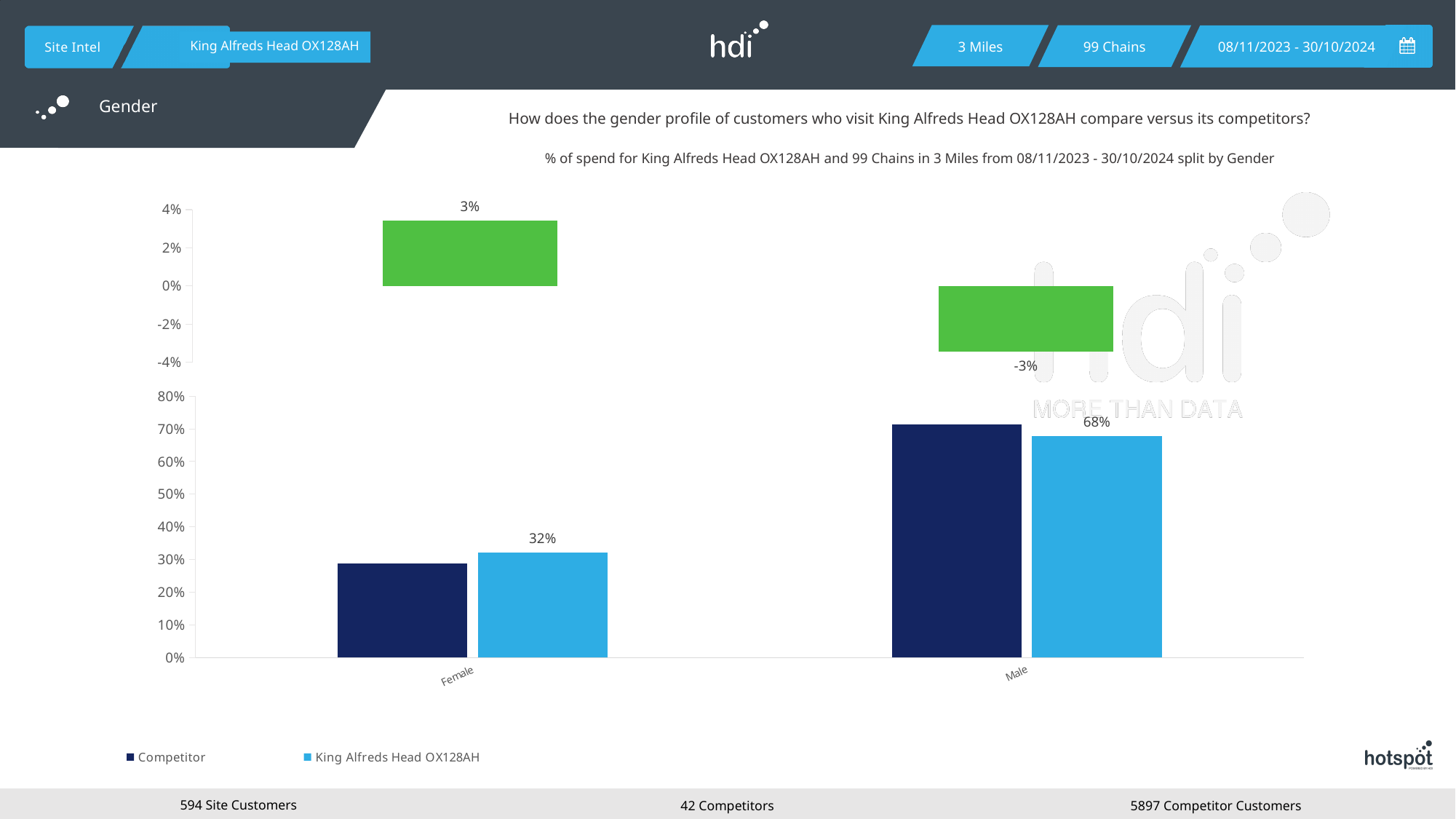
In the bottom bar chart, for Male, which series has the larger value, Competitor or King Alfreds Head OX128AH? Competitor In the top difference chart, what is the value shown for Female? 3% What type of chart is the bottom chart on the slide? Bar chart In the bottom bar chart, is the Competitor value for Female greater or less than 30%? less How many categories are shown on the x axis of the bottom bar chart? 2 In the bottom bar chart, what is the value for King Alfreds Head OX128AH for Male? 68% In the top difference chart, what is the value shown for Male? -3% How many series does the legend of the bottom bar chart list? 2 In the bottom bar chart, is the Competitor value for Male greater or less than 70%? greater In the bottom bar chart, what is the value for King Alfreds Head OX128AH for Female? 32% In the bottom bar chart, what is the difference between the King Alfreds Head OX128AH values for Male and Female? 36% In the bottom bar chart, which category has the higher value for King Alfreds Head OX128AH, Female or Male? Male